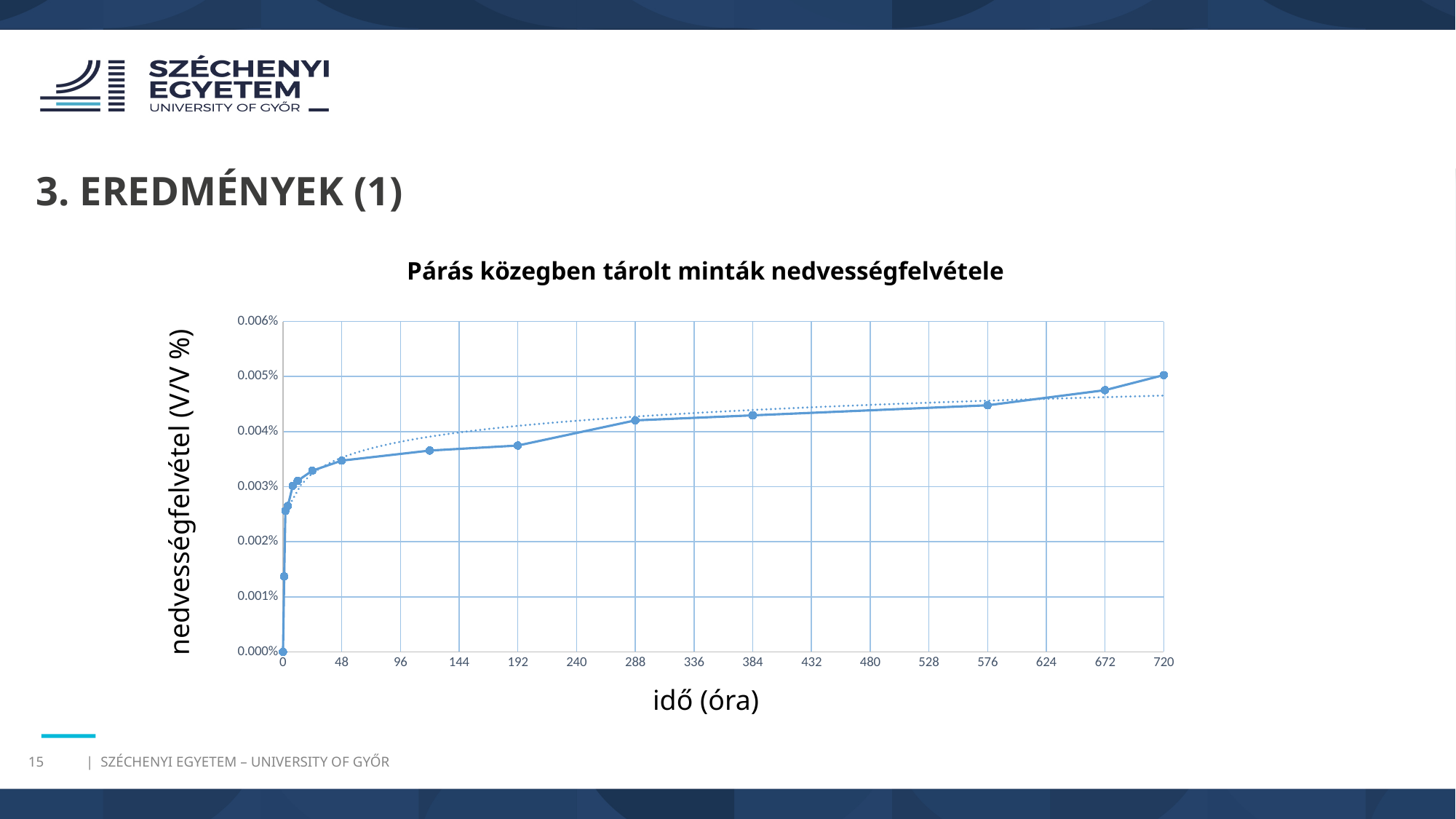
What is the moisture uptake value at time 0? 0.000% At which time (hours) is the plotted moisture uptake highest? 720 At which time (hours) is the plotted moisture uptake lowest? 0 What is the label of the x axis? idő (óra) What is the title of the chart? Párás közegben tárolt minták nedvességfelvétele Do the plotted values rise or fall as time increases along the x axis? rise Is the value at 192 hours greater or less than 0.004%? less Is the value at 576 hours greater or less than 0.005%? less Is the value at 48 hours greater or less than 0.004%? less Which has the larger moisture uptake value: 48 hours or 720 hours? 720 hours What kind of chart is shown on the slide? line chart